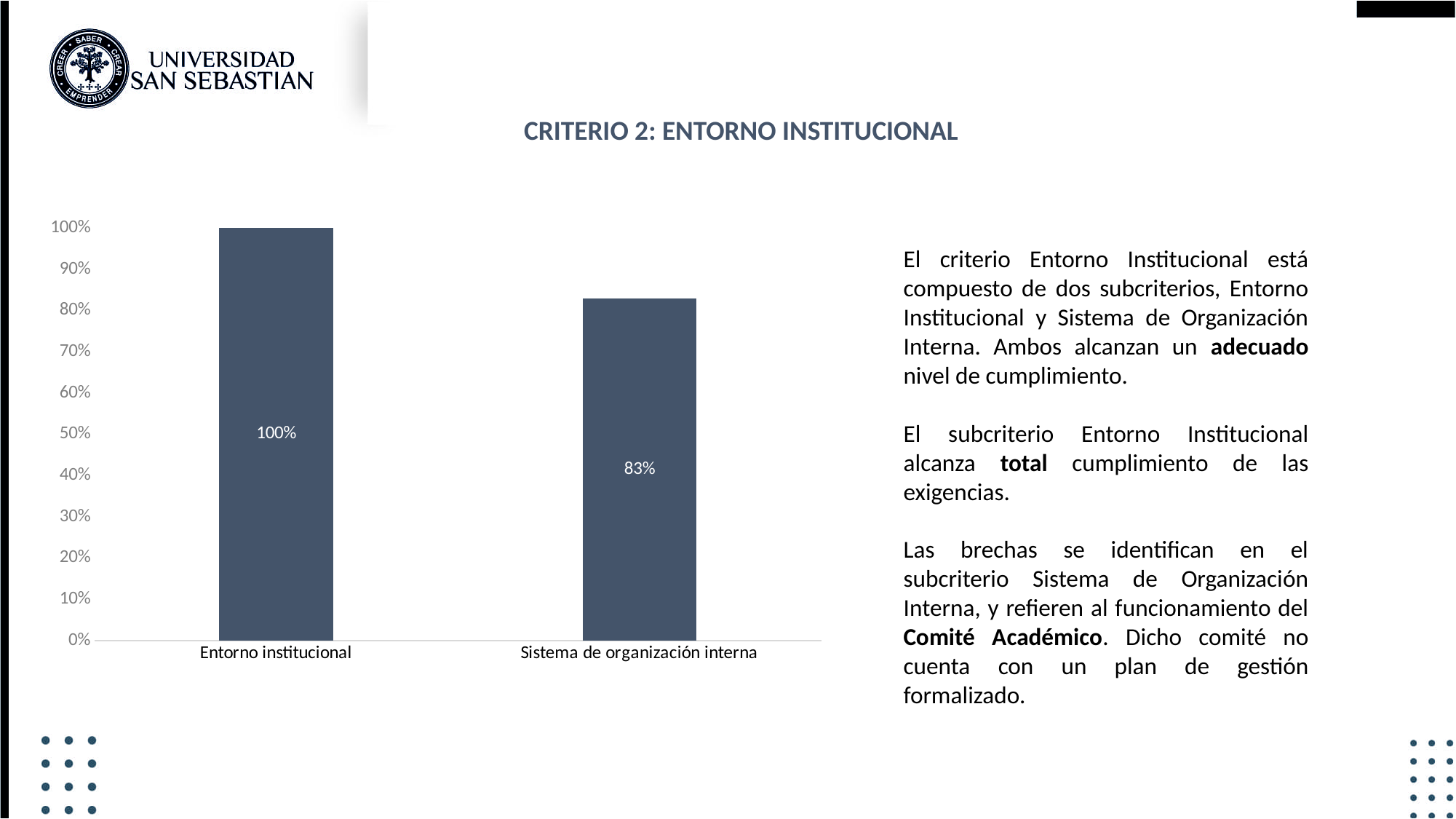
What is the value for Sistema de organización interna? 83% What is the highest tick value shown on the vertical axis? 100% How many categories are shown in the chart? 2 What is the difference between the values for Entorno institucional and Sistema de organización interna? 17% Is the value for Sistema de organización interna greater or less than 90%? less What is the value for Entorno institucional? 100% What is the title shown above the chart? CRITERIO 2: ENTORNO INSTITUCIONAL Which category has the highest value? Entorno institucional Which is larger, the value for Entorno institucional or the value for Sistema de organización interna? Entorno institucional Do the values rise or fall from left to right along the x axis? fall What kind of chart is shown on the slide? bar chart Which category has the lowest value? Sistema de organización interna